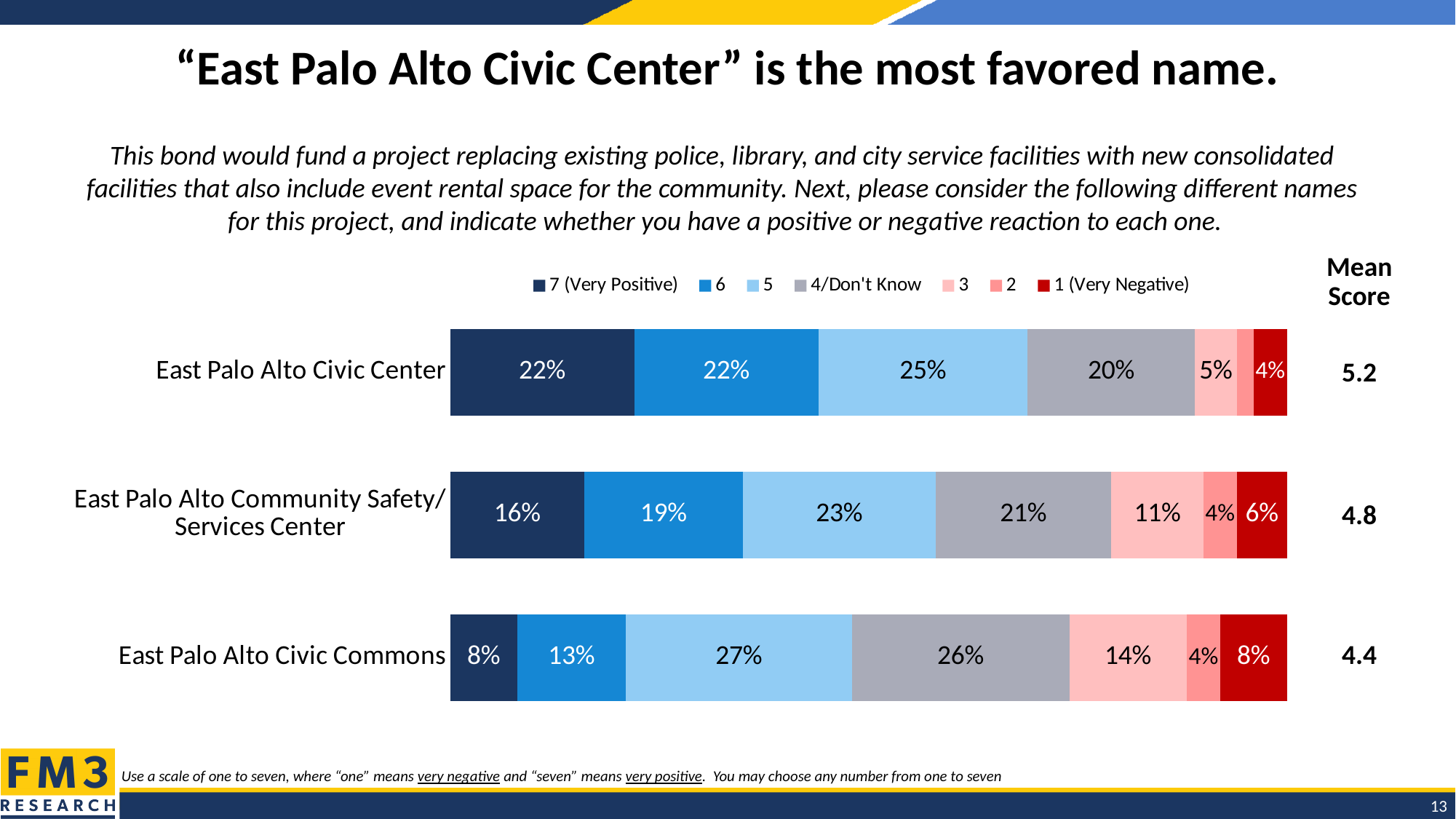
What percentage of respondents rated "East Palo Alto Civic Center" as 7 (Very Positive)? 22% What percentage of respondents rated "East Palo Alto Civic Commons" as 1 (Very Negative)? 8% What is the total of the segments in the "East Palo Alto Civic Commons" bar? 100% Which name has the lowest share of 7 (Very Positive) ratings? East Palo Alto Civic Commons Which is larger: the 3 rating for "East Palo Alto Civic Commons" or the 3 rating for "East Palo Alto Community Safety/Services Center"? East Palo Alto Civic Commons What kind of chart is shown on the slide? Stacked bar chart What is the difference between the 4/Don't Know share for "East Palo Alto Civic Commons" and for "East Palo Alto Civic Center"? 6 percentage points Which name has the highest share of 7 (Very Positive) ratings? East Palo Alto Civic Center What is the value of the 5 rating for "East Palo Alto Community Safety/Services Center"? 23% How many series does the legend list? 7 What is the mean score shown for "East Palo Alto Community Safety/Services Center"? 4.8 How many project names (categories) are shown in the chart? 3